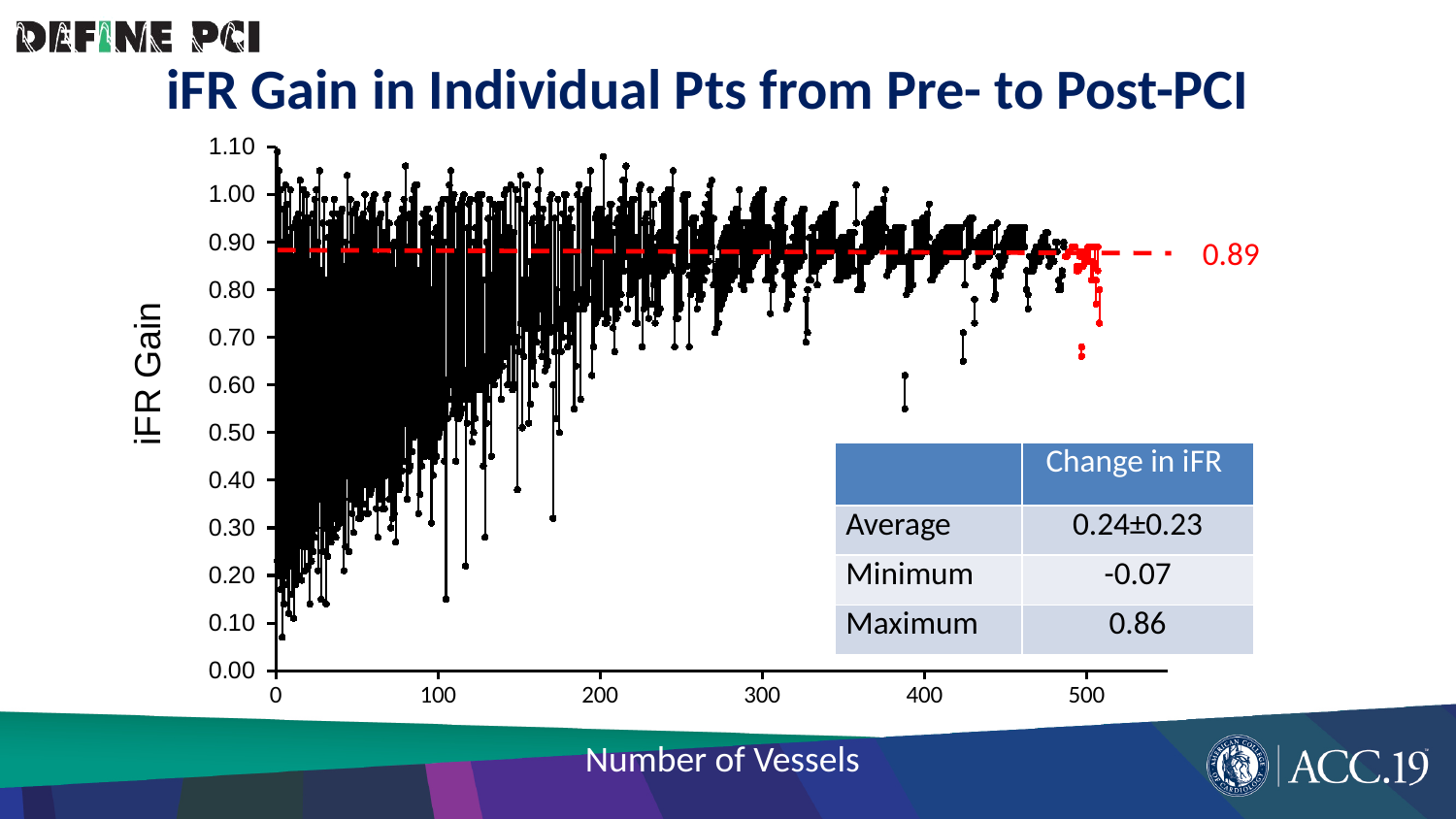
According to the table on the chart, what is the average change in iFR? 0.24±0.23 What is the highest tick value shown on the y axis of the chart? 1.10 According to the table on the chart, what is the maximum change in iFR? 0.86 Is the value of the red dashed line greater or less than 1.00? less What is the difference between the maximum and minimum change in iFR shown in the table? 0.93 Is the value of the red dashed line greater or less than 0.80? greater What value is marked by the red dashed horizontal line on the chart? 0.89 Do the lower ends of the plotted vertical lines generally rise or fall as the number of vessels increases along the x axis? rise According to the table on the chart, what is the minimum change in iFR? -0.07 Which is larger, the maximum change in iFR or the minimum change in iFR in the table? Maximum What is the title of the chart on the slide? iFR Gain in Individual Pts from Pre- to Post-PCI What is the label of the y axis of the chart? iFR Gain